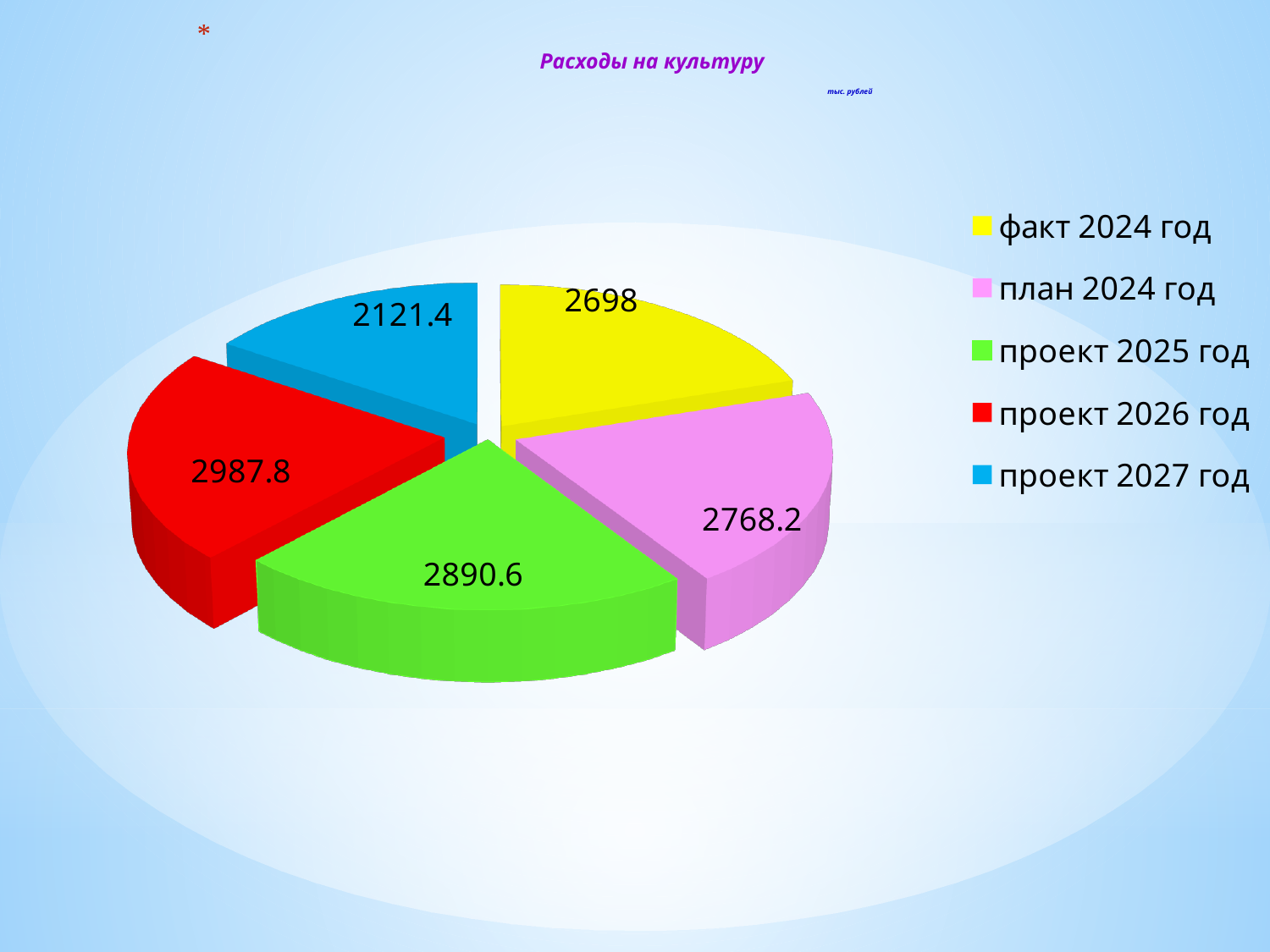
What is the value for проект 2025 год? 2890.6 What is the value for факт 2024 год? 2698 Which is larger, the value for план 2024 год or the value for факт 2024 год? план 2024 год What is the difference between the values for проект 2025 год and план 2024 год? 122.4 What is the title of the chart? Расходы на культуру What is the value for план 2024 год? 2768.2 What is the difference between the values for проект 2026 год and проект 2027 год? 866.4 What type of chart is shown on the slide? Pie chart What is the value for проект 2027 год? 2121.4 Which category has the highest value? проект 2026 год How many categories does the legend list? 5 Which category has the lowest value? проект 2027 год